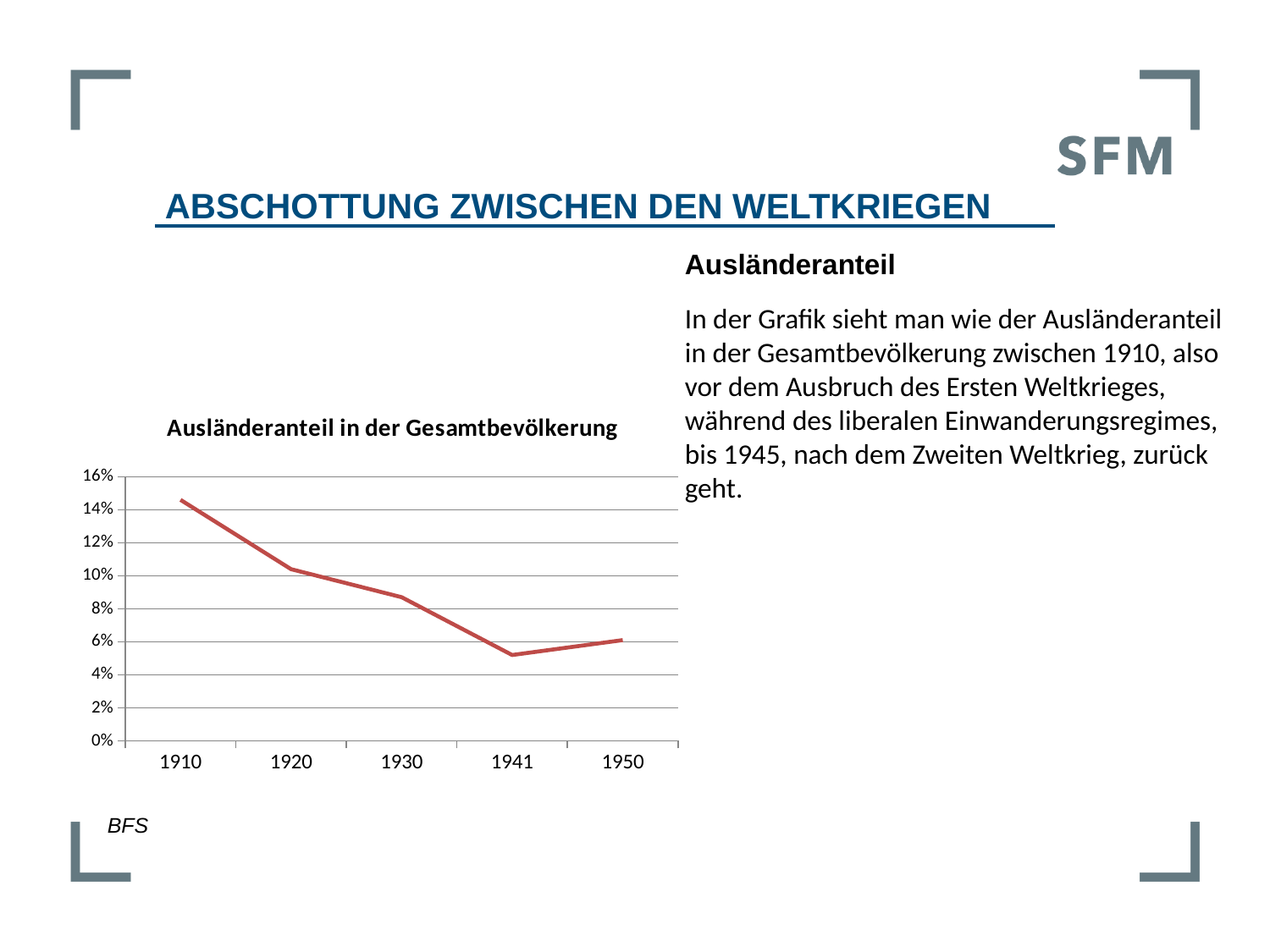
Is the value for 1930 greater or less than 10%? less In which year is the Ausländeranteil highest? 1910 Which year has the larger Ausländeranteil, 1941 or 1950? 1950 In which year is the Ausländeranteil lowest? 1941 What is the title of the chart? Ausländeranteil in der Gesamtbevölkerung How many years are plotted on the x axis of the chart? 5 Is the value for 1941 greater or less than 6%? less Is the value for 1950 greater or less than 8%? less What kind of chart is shown on the slide? line chart Does the Ausländeranteil generally rise or fall from 1910 to 1941? fall Which year has the larger Ausländeranteil, 1920 or 1930? 1920